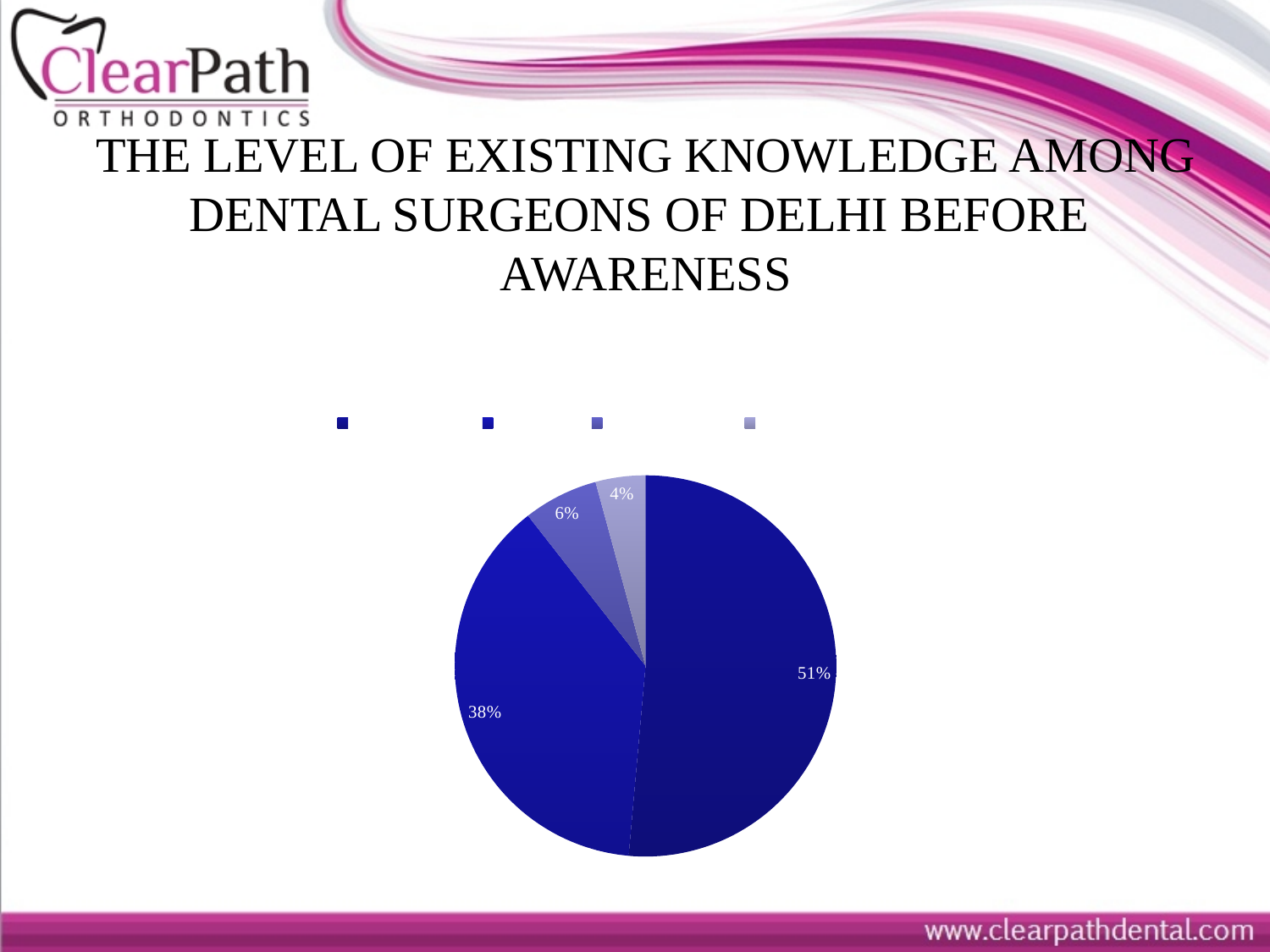
What is the difference between the largest slice (51%) and the second-largest slice (38%)? 13% What is the value of the largest slice in the pie chart? 51% What is the combined share of the two smallest slices (6% and 4%)? 10% How many slices does the pie chart have? 4 What is the title of the slide containing the pie chart? THE LEVEL OF EXISTING KNOWLEDGE AMONG DENTAL SURGEONS OF DELHI BEFORE AWARENESS What is the value of the second-largest slice in the pie chart? 38% What kind of chart is shown on the slide? Pie chart Which is larger, the 6% slice or the 4% slice? The 6% slice Is the largest slice of the pie chart greater or less than 50%? greater How many entries does the legend above the pie chart list? 4 What is the value of the smallest slice in the pie chart? 4% What is the difference between the 6% slice and the 4% slice? 2%